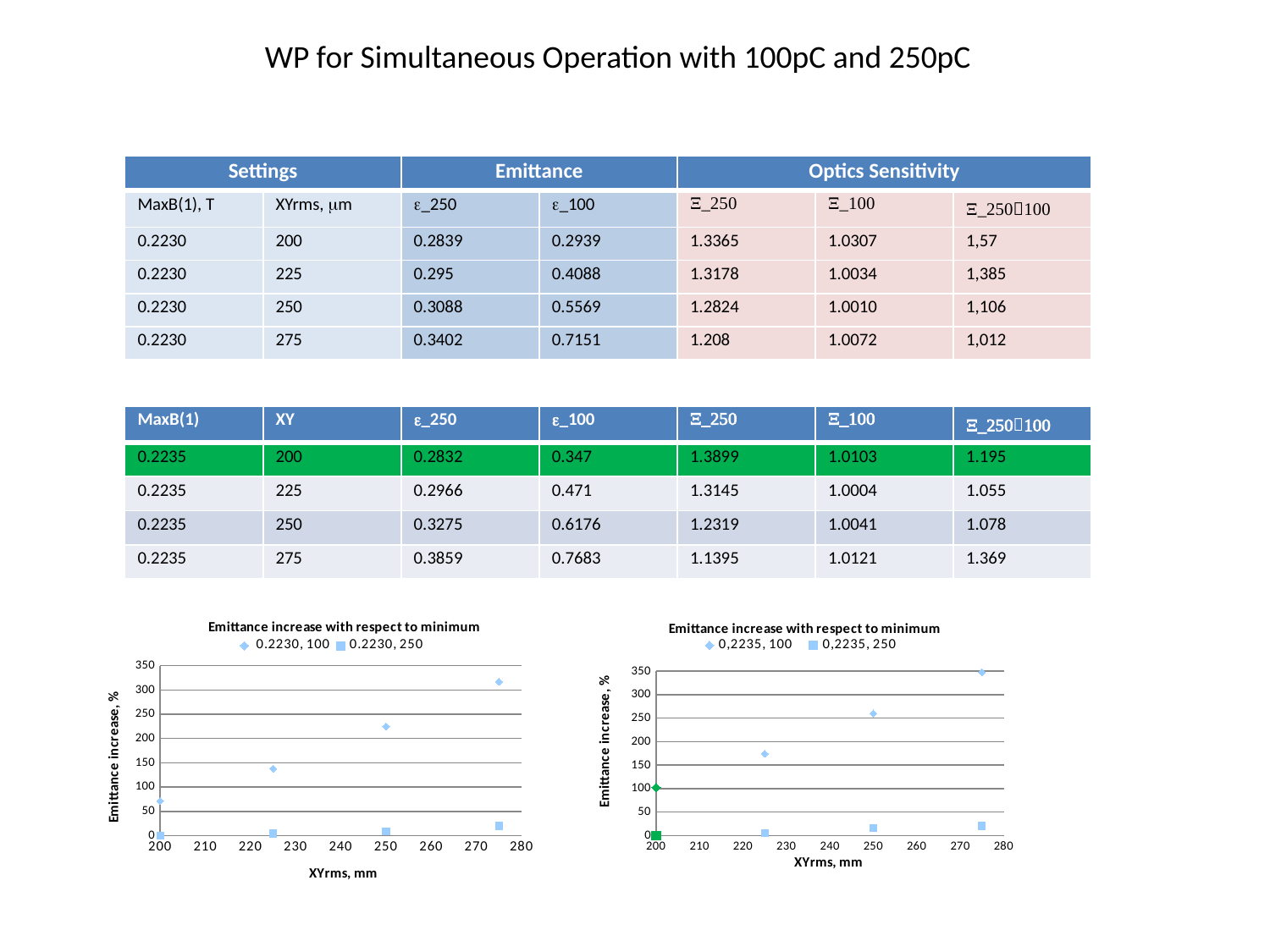
In the left chart, is the value for the series '0.2230, 100' at XYrms 275 greater or less than 300? greater What is the y-axis title of the left chart? Emittance increase, % How many series does the legend of the left chart list? 2 In the right chart, is the value for the series '0,2235, 100' at XYrms 275 greater or less than 300? greater What kind of chart is the left chart, 'Emittance increase with respect to minimum' with legend 0.2230? scatter chart In the right chart, is the value for the series '0,2235, 100' at XYrms 225 greater or less than 150? greater In the left chart, do the values of the series '0.2230, 100' rise or fall as XYrms increases from 200 to 280? rise In the left chart, how many points are plotted for the series '0.2230, 100'? 4 What is the x-axis title of the right chart? XYrms, mm In the left chart, which series has the larger value at XYrms 275, '0.2230, 100' or '0.2230, 250'? 0.2230, 100